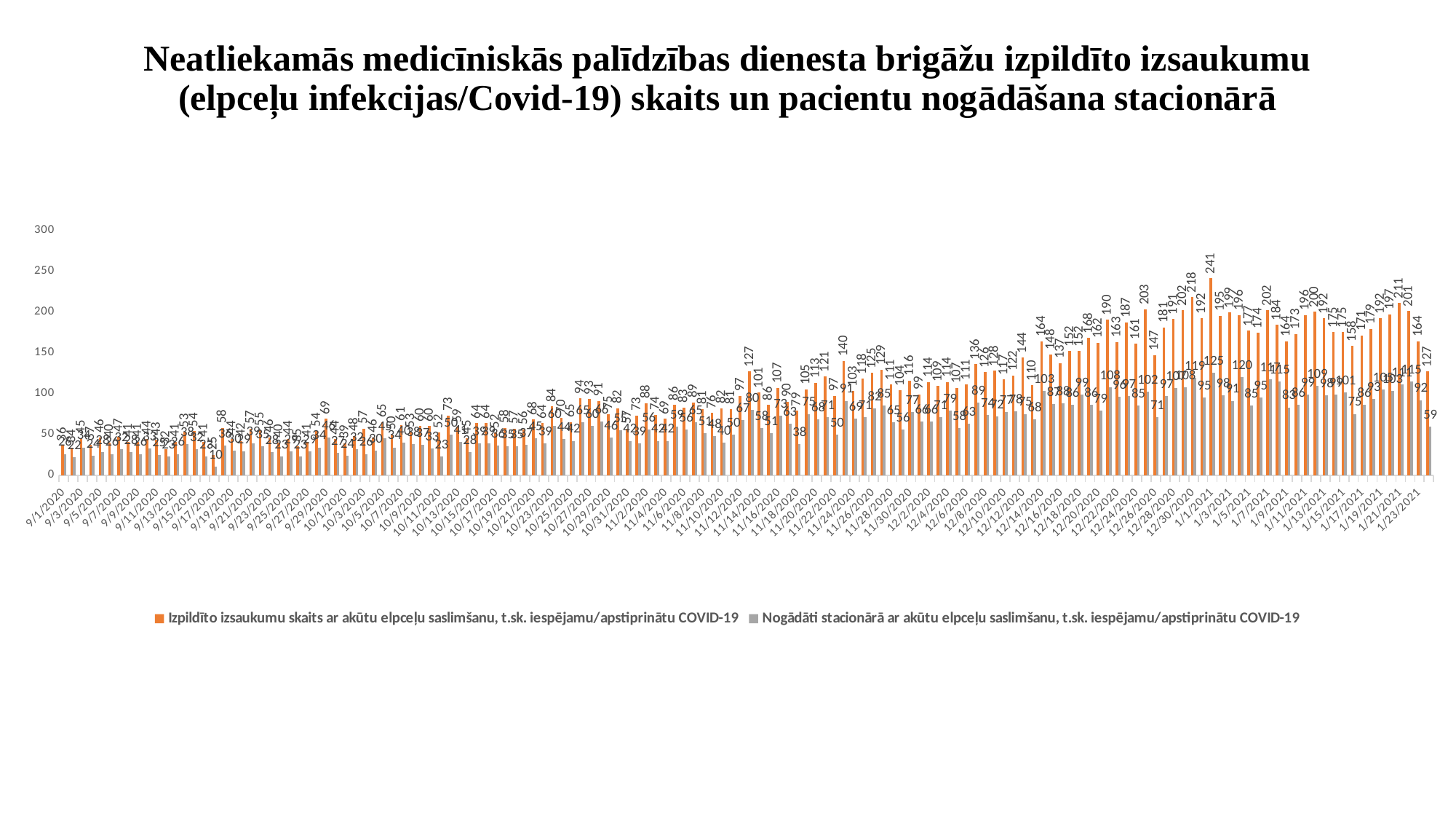
What is the value of the rightmost orange bar? 127 What is the value of the rightmost gray bar? 59 What kind of chart is shown on the slide? bar chart What is the difference between the rightmost orange bar (127) and the rightmost gray bar (59)? 68 What does the orange series represent according to the legend? Izpildīto izsaukumu skaits ar akūtu elpceļu saslimšanu, t.sk. iespējamu/apstiprinātu COVID-19 What is the maximum value shown on the vertical axis? 300 Do the values of the orange series generally rise or fall from September 2020 to January 2021? rise How many series does the legend list? 2 What is the highest value reached by the orange series (Izpildīto izsaukumu skaits)? 241 Is the highest orange bar greater or less than 200? greater Which series generally has the higher values, the orange one or the gray one? orange Is the first orange bar (9/1/2020) greater or less than 50? less